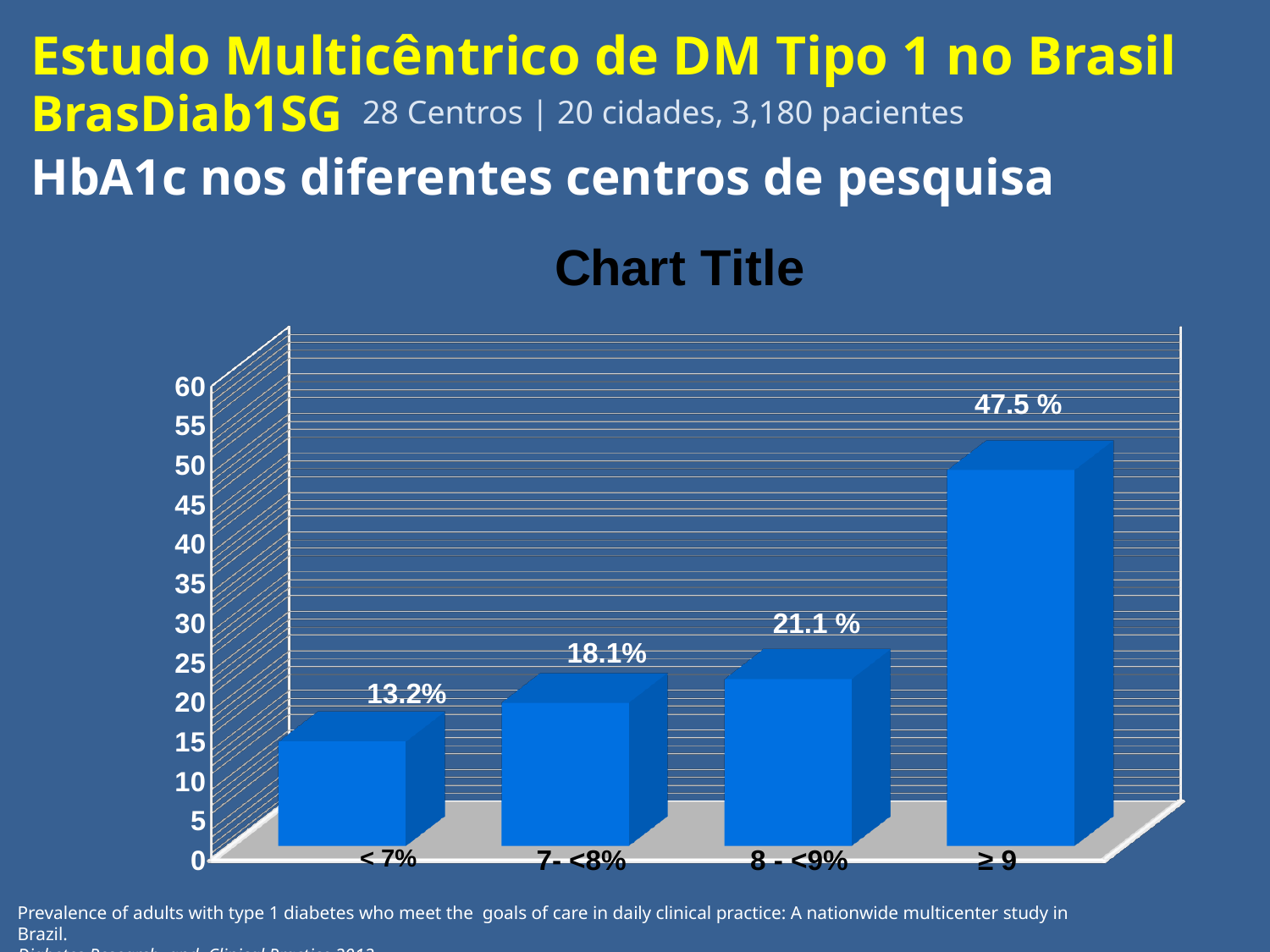
What is the difference between the values for "≥ 9" and "8 - <9%"? 26.4 How many categories are shown on the x axis? 4 What kind of chart is shown on the slide? bar chart What is the value shown for the "< 7%" category? 13.2% What is the value shown for the "≥ 9" category? 47.5 % Which category has the highest value? ≥ 9 What is the value shown for the "7- <8%" category? 18.1% What is the difference between the values for "7- <8%" and "< 7%"? 4.9 Which category has the lowest value? < 7% Do the values rise or fall moving from left to right along the x axis? rise What is the value shown for the "8 - <9%" category? 21.1 % Which is larger, the value for "8 - <9%" or the value for "7- <8%"? 8 - <9%